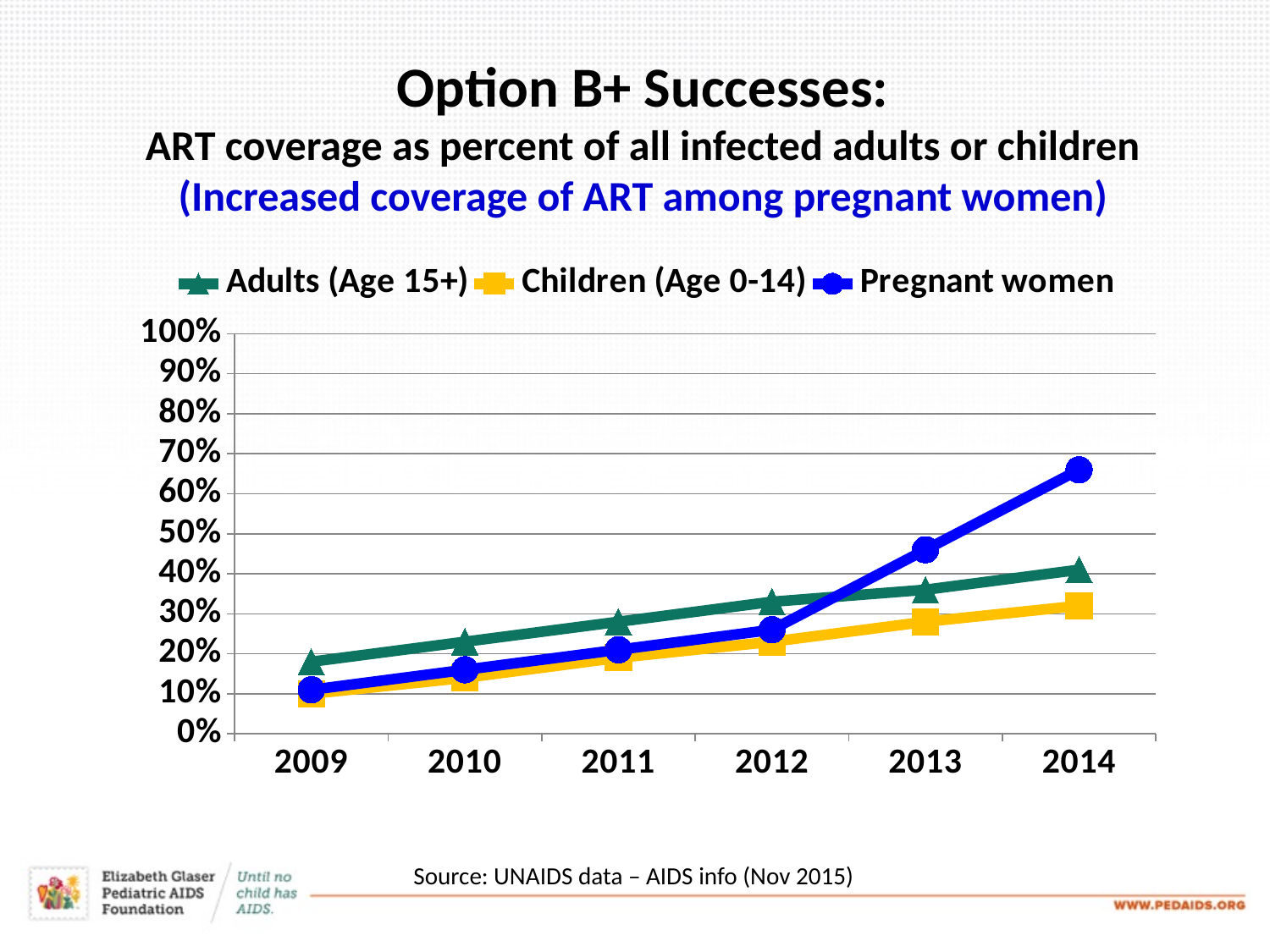
In which year is the value for Pregnant women highest? 2014 Is the value for Pregnant women in 2013 greater or less than 40%? greater Which series has the highest value in 2014? Pregnant women How many series does the legend list? 3 Is the value for Children (Age 0-14) in 2014 greater or less than 40%? less Does the value for Adults (Age 15+) rise or fall from 2009 to 2014? rise Which series has the lowest value in 2014? Children (Age 0-14) In 2013, which is larger: the value for Pregnant women or the value for Adults (Age 15+)? Pregnant women Is the value for Adults (Age 15+) in 2014 greater or less than 50%? less What kind of chart is shown on the slide? Line chart How many years are shown on the x axis? 6